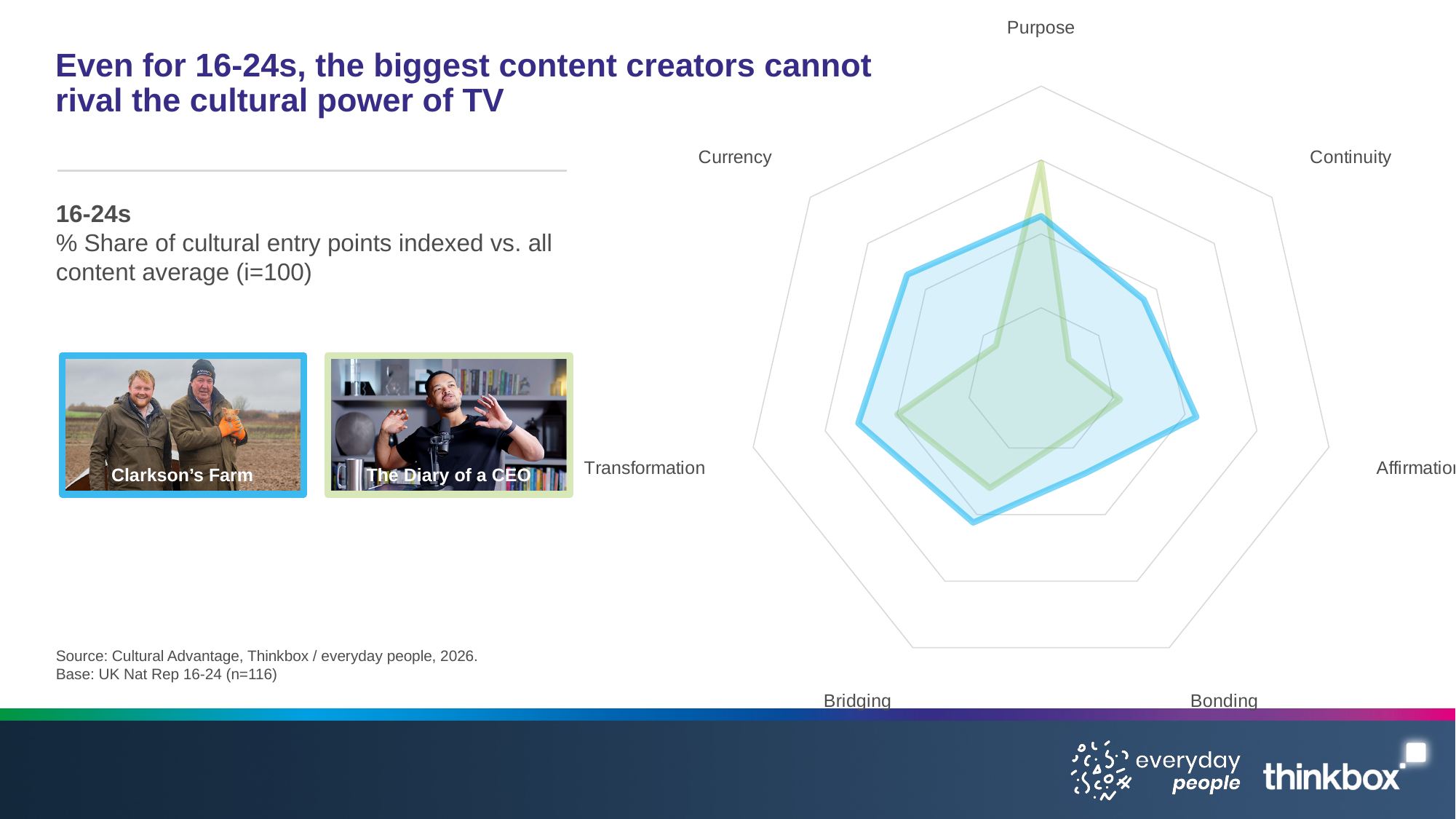
On which single axis does The Diary of a CEO exceed Clarkson's Farm? Purpose How many series are plotted on the radar chart? 2 On the Purpose axis, which scores higher: Clarkson's Farm or The Diary of a CEO? The Diary of a CEO How many axes (cultural entry points) does the radar chart have? 7 Which two pieces of content are compared on the radar chart? Clarkson's Farm and The Diary of a CEO What kind of chart is shown on the slide? Radar chart On the Currency axis, which scores higher: Clarkson's Farm or The Diary of a CEO? Clarkson's Farm On which axis does The Diary of a CEO score highest? Purpose Which colour represents Clarkson's Farm on the radar chart? Blue